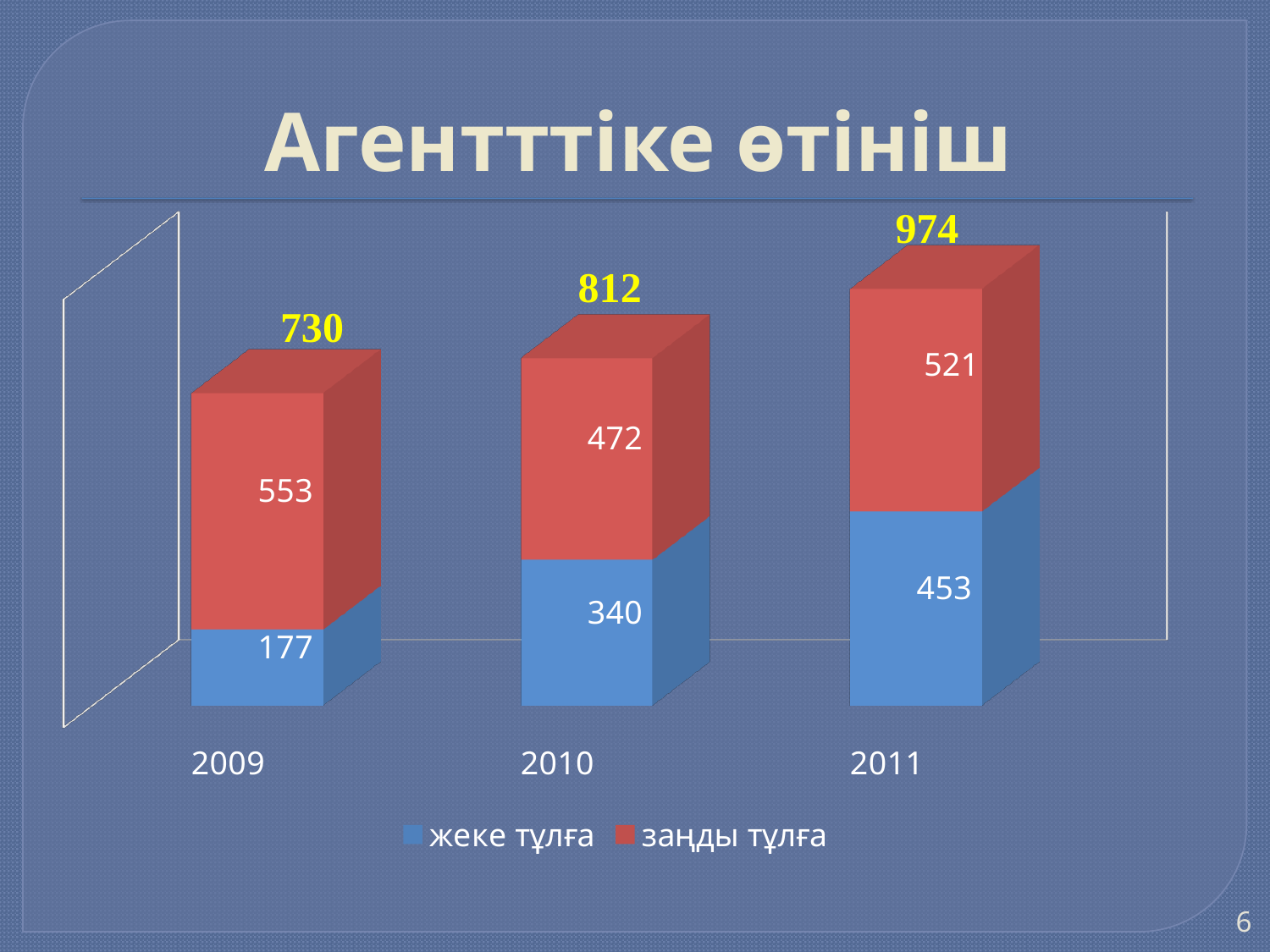
Which year has the lowest value for заңды тұлға? 2010 How many years are shown on the x axis? 3 Which year has the highest value for жеке тұлға? 2011 What is the value for заңды тұлға in 2009? 553 What is the value for заңды тұлға in 2011? 521 What is the total of the stacked bar for 2011? 974 What is the difference between the жеке тұлға values for 2011 and 2009? 276 What is the total of the stacked bar for 2009? 730 What is the value for жеке тұлға in 2010? 340 How many series does the legend list? 2 Do the stacked bar totals rise or fall from 2009 to 2011? rise Which is larger in 2010: жеке тұлға or заңды тұлға? заңды тұлға